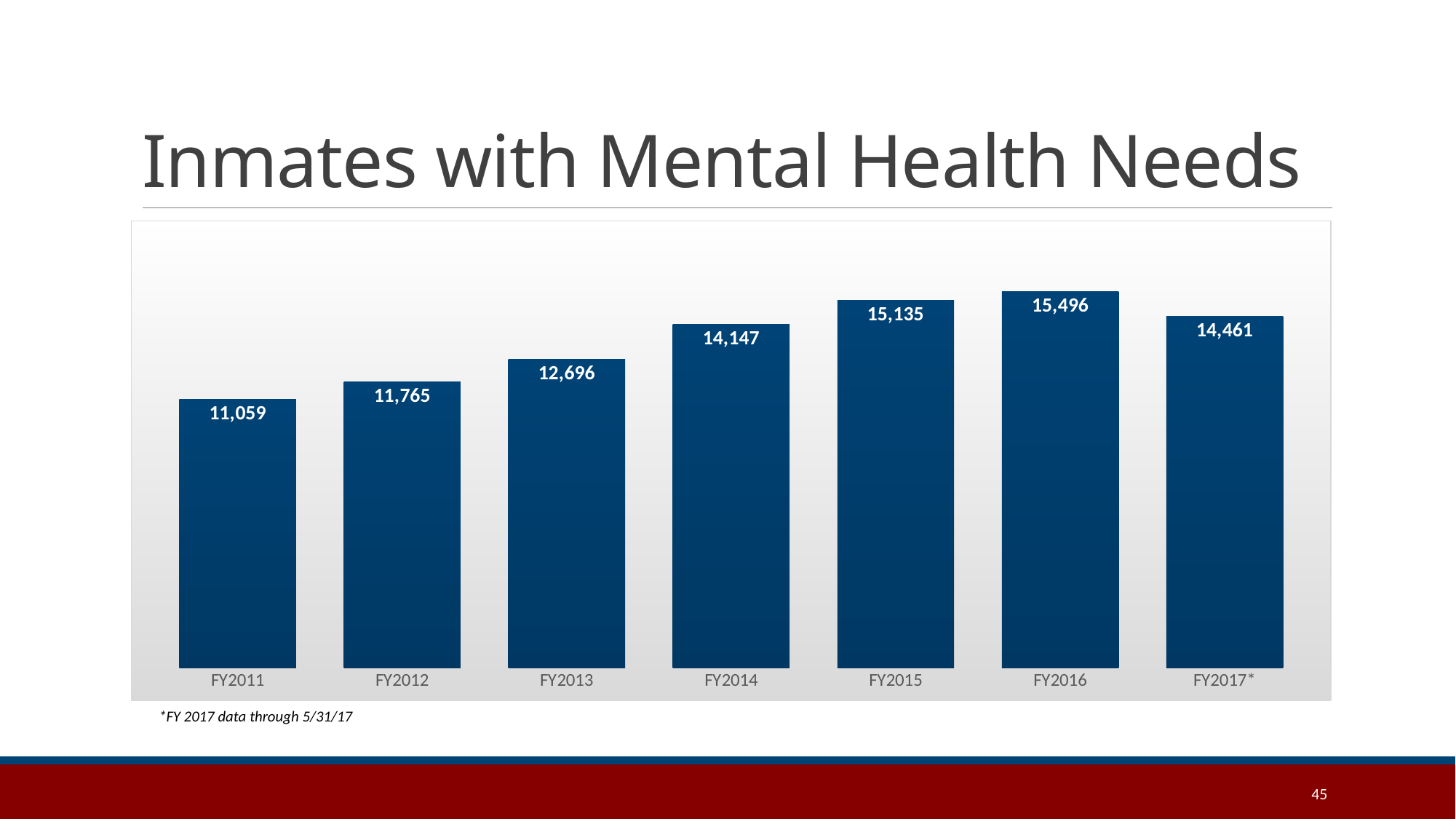
What is the title of the slide? Inmates with Mental Health Needs What is the value for FY2014? 14,147 What is the value for FY2011? 11,059 Which is larger, the value for FY2015 or the value for FY2017*? FY2015 Do the values rise or fall from FY2011 to FY2016? Rise How many fiscal years are shown on the chart? 7 Which fiscal year has the highest value? FY2016 Which fiscal year has the lowest value? FY2011 What kind of chart is shown on the slide? Bar chart What is the difference between the FY2016 and FY2017* values? 1,035 What is the value for FY2017*? 14,461 What is the difference between the FY2016 and FY2011 values? 4,437